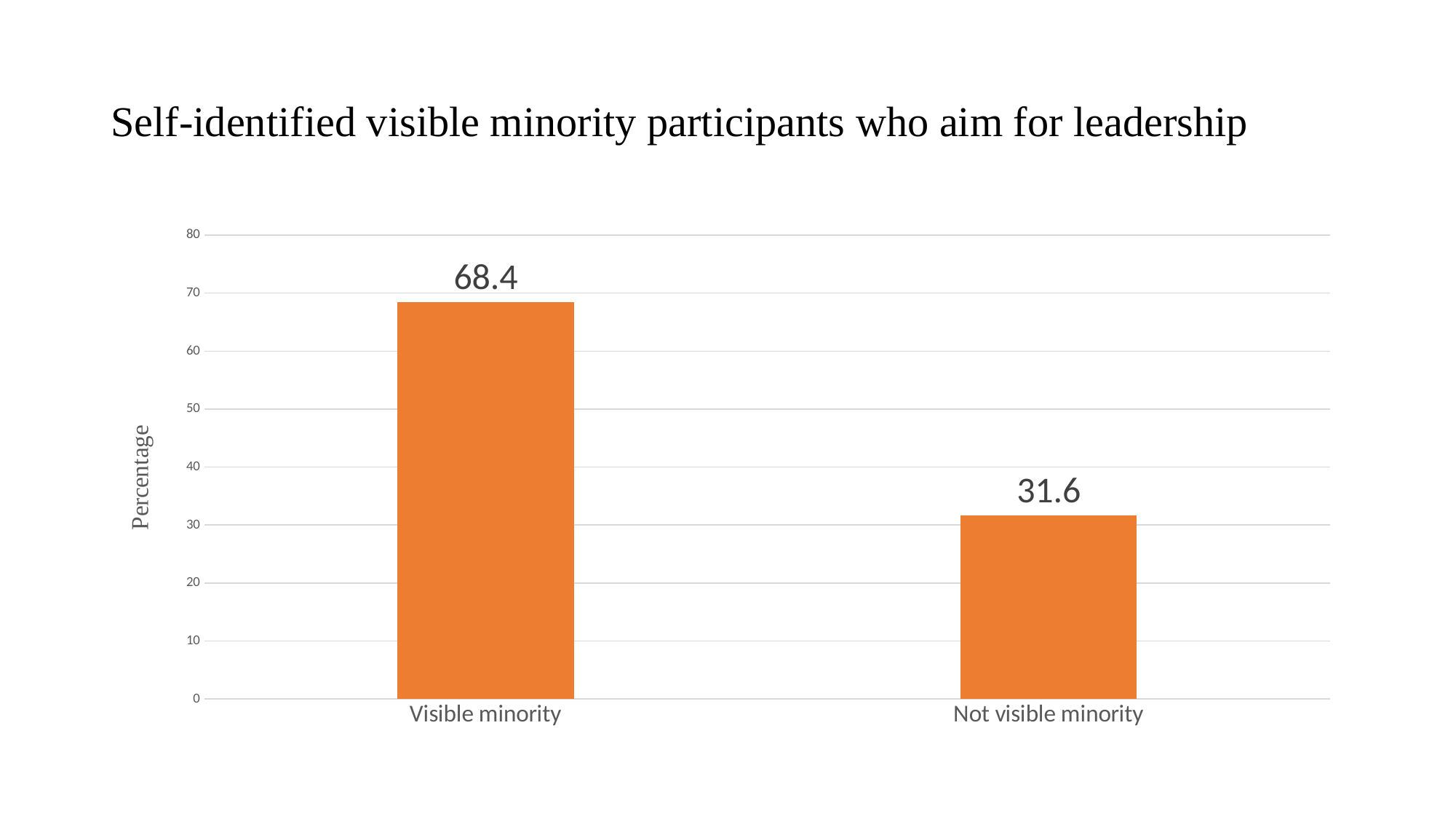
What is the label of the vertical axis? Percentage What kind of chart is shown on the slide? bar chart What is the title of the chart? Self-identified visible minority participants who aim for leadership Is the value for Visible minority greater or less than 60? greater Which category has the lowest value? Not visible minority What is the value for Not visible minority? 31.6 What is the difference between the values for Visible minority and Not visible minority? 36.8 How many categories are shown on the x axis? 2 Which is larger, the value for Visible minority or the value for Not visible minority? Visible minority Is the value for Not visible minority greater or less than 40? less What is the value for Visible minority? 68.4 Which category has the highest value? Visible minority